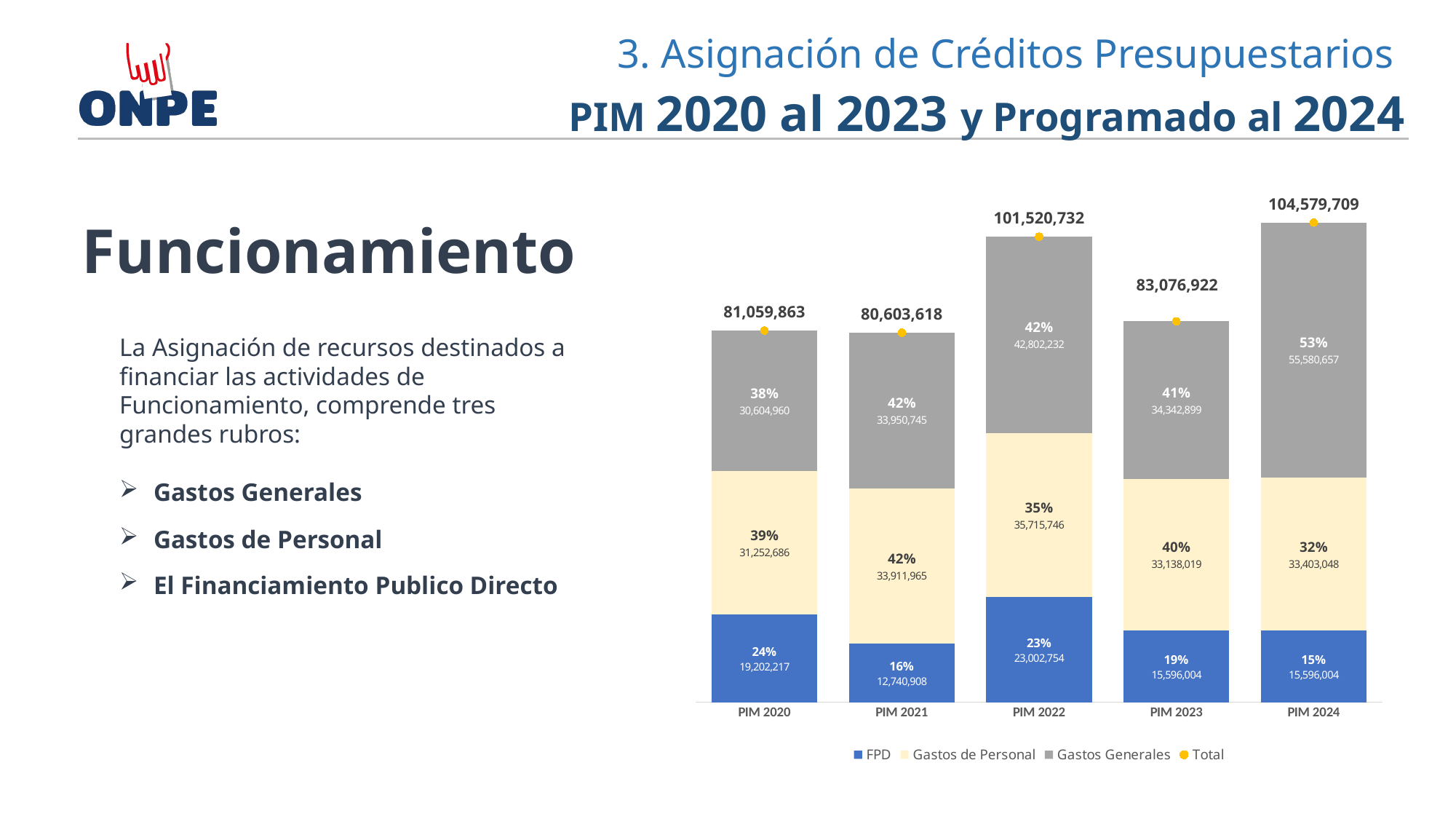
What is the total value shown for PIM 2022? 101,520,732 What is the difference between the FPD values for PIM 2022 and PIM 2021? 10,261,846 What is the difference between the totals for PIM 2024 and PIM 2023? 21,502,787 What kind of chart is shown on the slide? Stacked bar chart Which year has the highest total? PIM 2024 How many entries does the legend list? 4 What is the Gastos Generales value for PIM 2024? 55,580,657 What is the Gastos de Personal value for PIM 2020? 31,252,686 Which is larger, the Gastos Generales value for PIM 2022 or for PIM 2023? PIM 2022 What percentage does FPD represent in PIM 2021? 16% How many years (bars) are shown on the chart? 5 Which year has the lowest total? PIM 2021